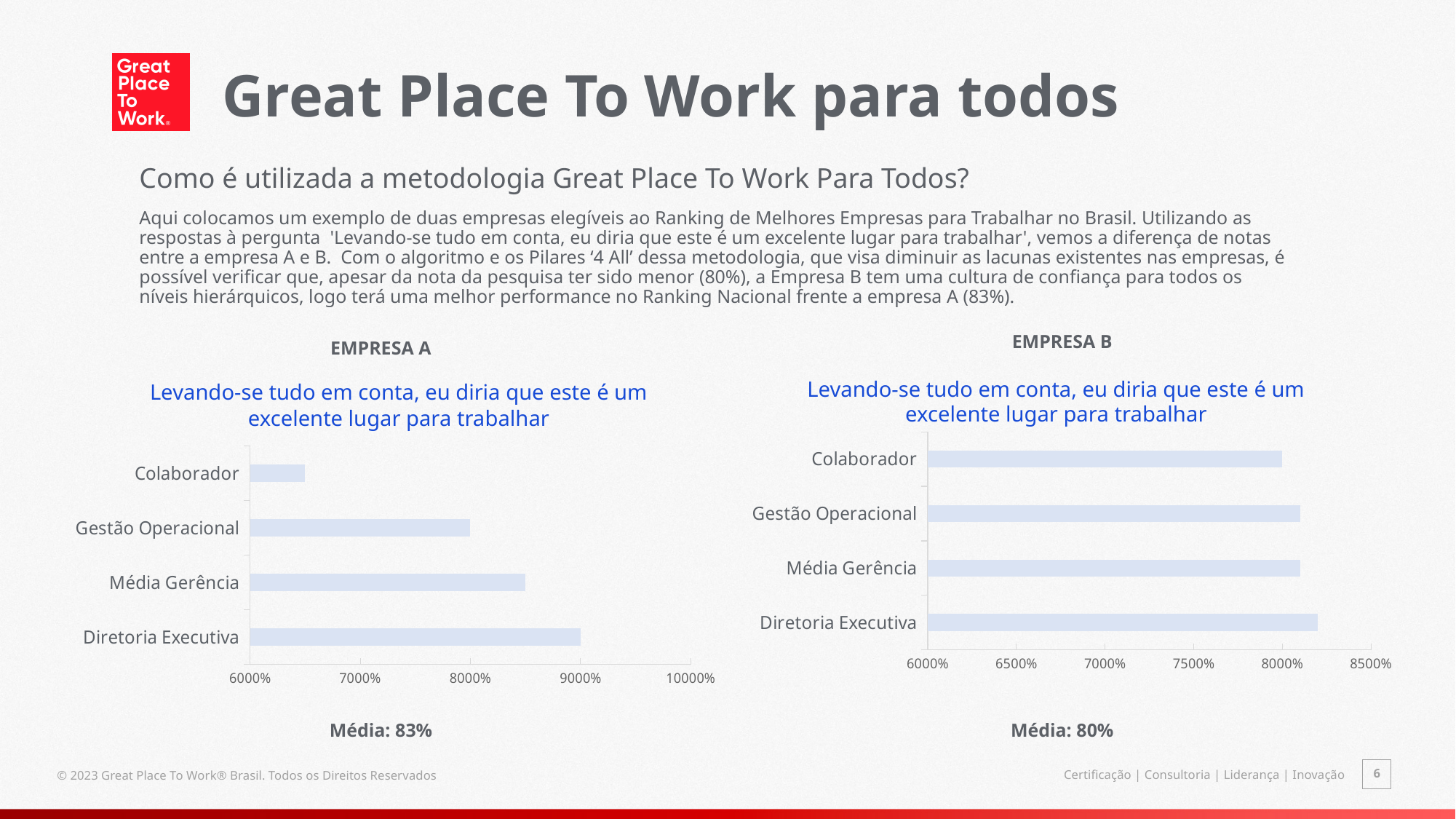
What kind of chart is the EMPRESA A chart? bar chart On the EMPRESA B chart, which is larger, the value for Colaborador or the value for Diretoria Executiva? Diretoria Executiva On the EMPRESA A chart, what is the value for Diretoria Executiva? 9000% On the EMPRESA B chart, which category has the lowest value? Colaborador On the EMPRESA A chart, which category has the lowest value? Colaborador On the EMPRESA B chart, is the value for Diretoria Executiva greater or less than 8000%? greater On the EMPRESA A chart, which category has the highest value? Diretoria Executiva On the EMPRESA A chart, is the value for Média Gerência greater or less than 8000%? greater On the EMPRESA A chart, is the value for Colaborador greater or less than 7000%? less What average (Média) is shown below the EMPRESA B chart? 80% How many categories are shown on the EMPRESA A chart? 4 How many categories are shown on the EMPRESA B chart? 4